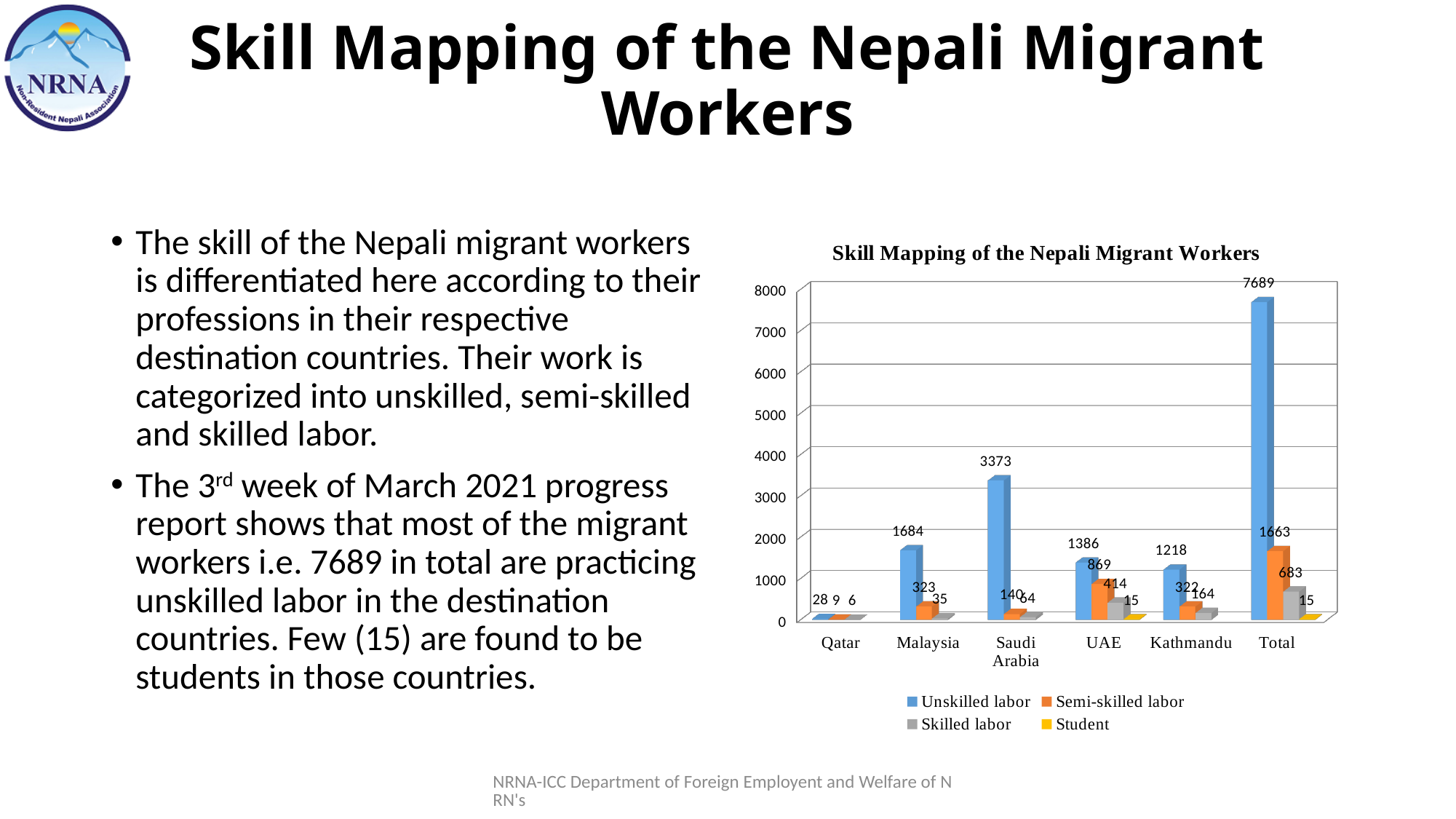
What is the difference between the Unskilled labor values for Malaysia and UAE? 298 What is the value for Skilled labor in Kathmandu? 164 How many series does the legend list? 4 How many categories are shown on the x axis? 6 Which category has the lowest Unskilled labor value? Qatar What is the Total value for Unskilled labor? 7689 Which is larger, the Semi-skilled labor value for Malaysia or for Kathmandu? Malaysia What kind of chart is shown on the slide? Bar chart Excluding the Total category, which country has the highest Unskilled labor value? Saudi Arabia What is the value for Unskilled labor in Saudi Arabia? 3373 Is the Unskilled labor value for Kathmandu greater or less than 1000? greater What is the value for Semi-skilled labor in UAE? 869